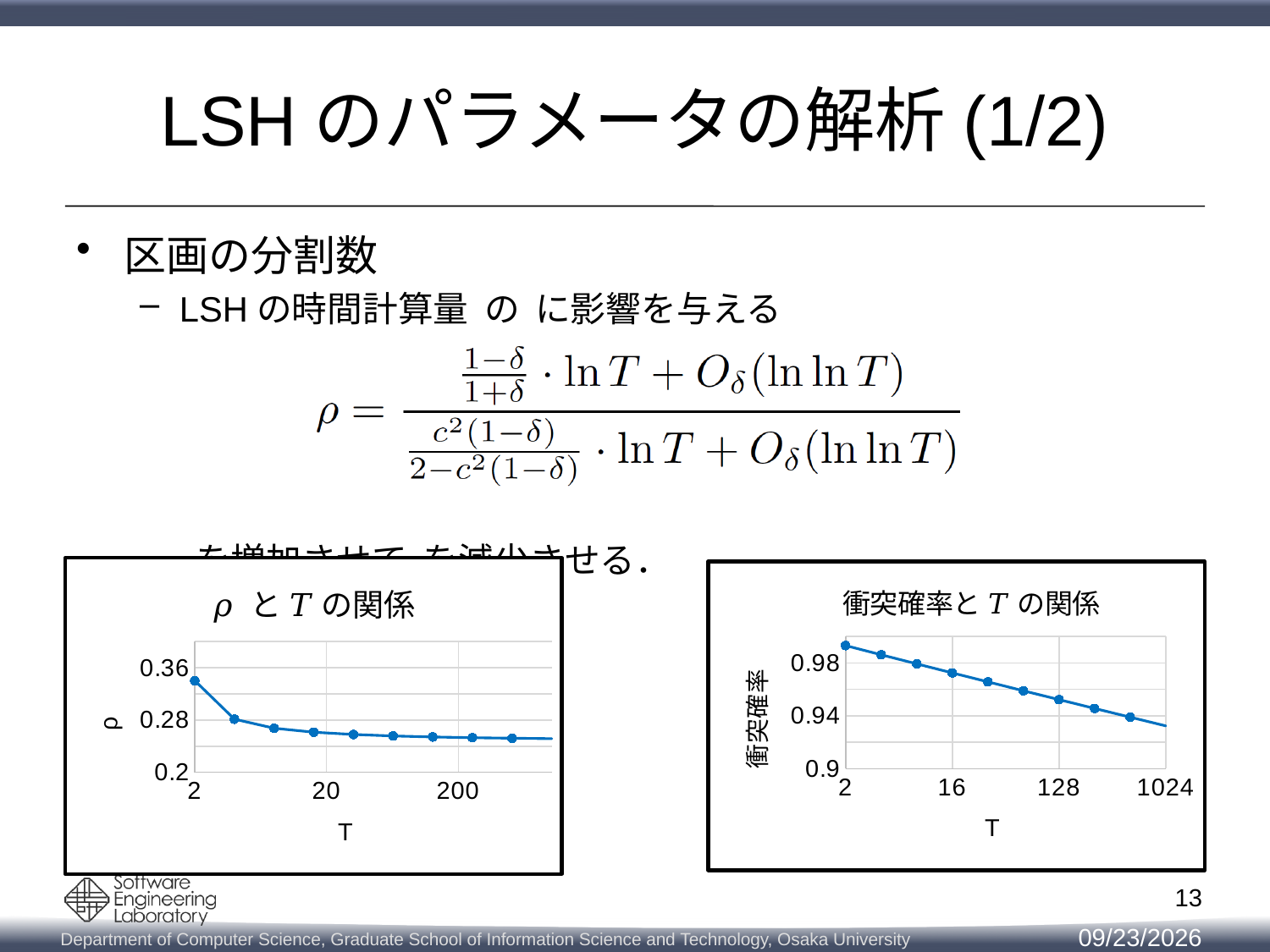
In the left chart "ρ と T の関係", is the value of ρ at T = 2 greater or less than 0.36? less What kind of chart is the left chart titled "ρ と T の関係"? line chart What is the label of the y axis in the right chart "衝突確率と T の関係"? 衝突確率 In the right chart "衝突確率と T の関係", is the collision probability at T = 128 greater or less than 0.94? greater In the right chart "衝突確率と T の関係", does the collision probability rise or fall as T increases? fall In the right chart "衝突確率と T の関係", is the collision probability at T = 2 greater or less than 0.98? greater In the left chart "ρ と T の関係", does ρ rise or fall as T increases? fall What is the label of the x axis in the right chart "衝突確率と T の関係"? T What kind of chart is the right chart titled "衝突確率と T の関係"? line chart